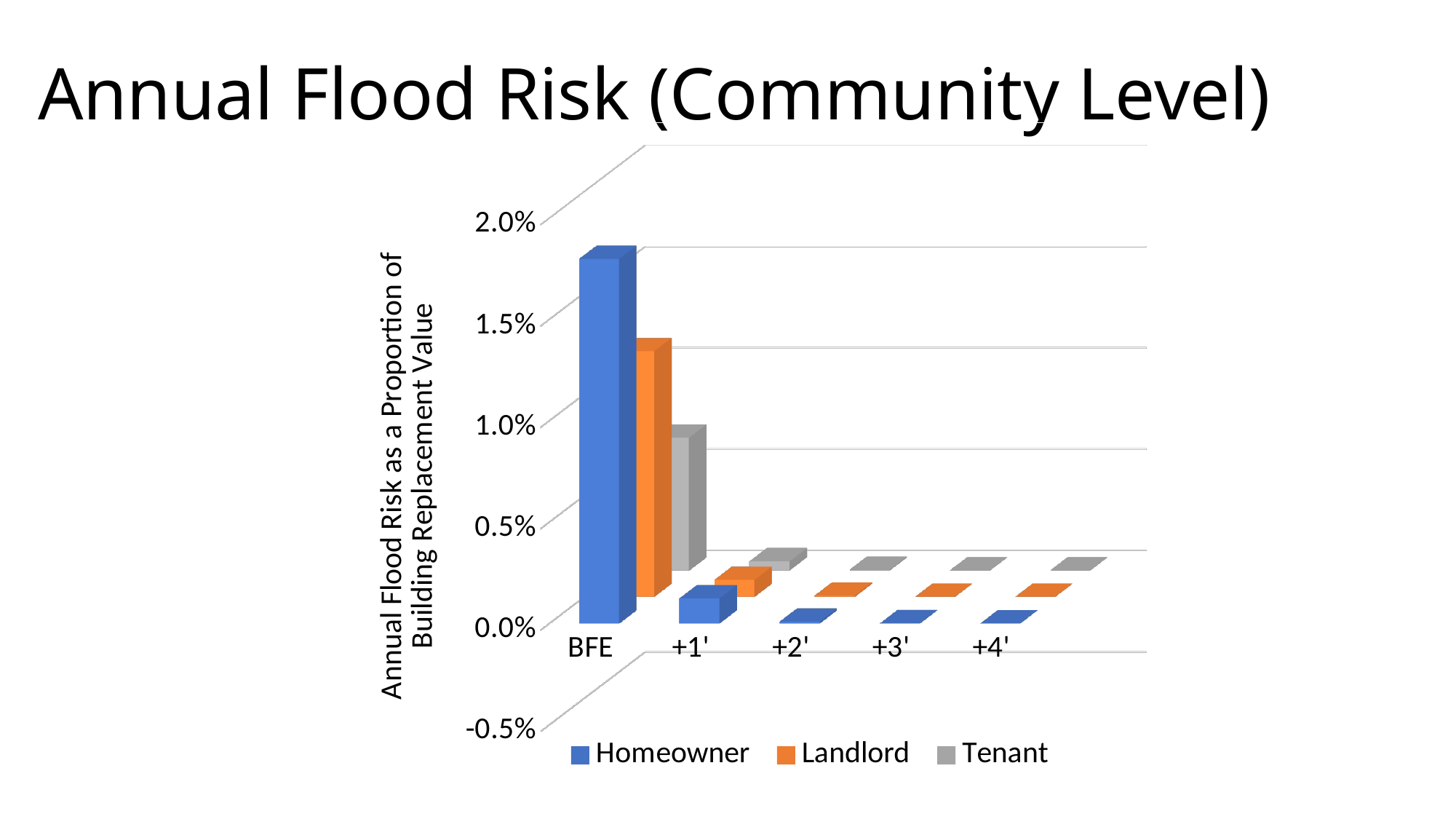
Which series has the highest value at BFE? Homeowner Do the Homeowner values rise or fall from BFE to +4'? fall How many series does the legend list? 3 What kind of chart is shown on the slide? bar chart Is the Tenant value at BFE greater or less than 1.5%? less Is the Homeowner value at +1' greater or less than 0.5%? less What is the title of the vertical axis? Annual Flood Risk as a Proportion of Building Replacement Value How many categories are shown on the x axis? 5 For the Homeowner series, which category has the highest value? BFE Is the Landlord value at BFE greater or less than 1.0%? greater At BFE, which is larger: the Homeowner value or the Tenant value? Homeowner